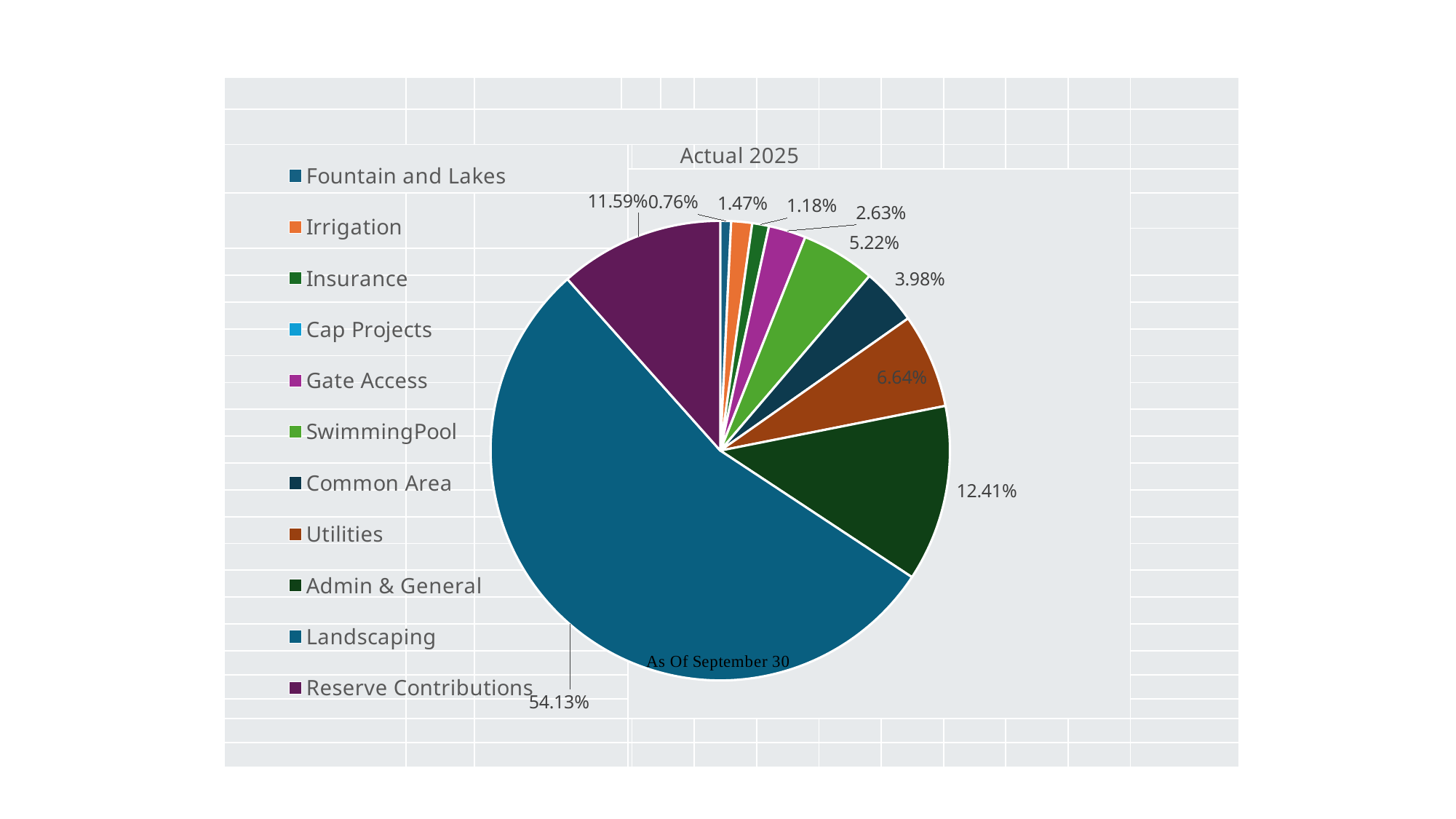
What percentage is shown for Reserve Contributions? 11.59% How many categories are listed in the legend? 11 What percentage is shown for Admin & General? 12.41% What percentage is shown for SwimmingPool? 5.22% What is the difference in percentage points between Landscaping and Admin & General? 41.72% Which category has the largest slice of the pie? Landscaping What share of the pie does Landscaping represent? 54.13% What percentage is shown for Utilities? 6.64% What is the title of the chart? Actual 2025 What type of chart is shown on the slide? pie chart Which is larger, the Utilities slice or the Common Area slice? Utilities What note is printed on the Landscaping slice near the bottom of the pie? As Of September 30